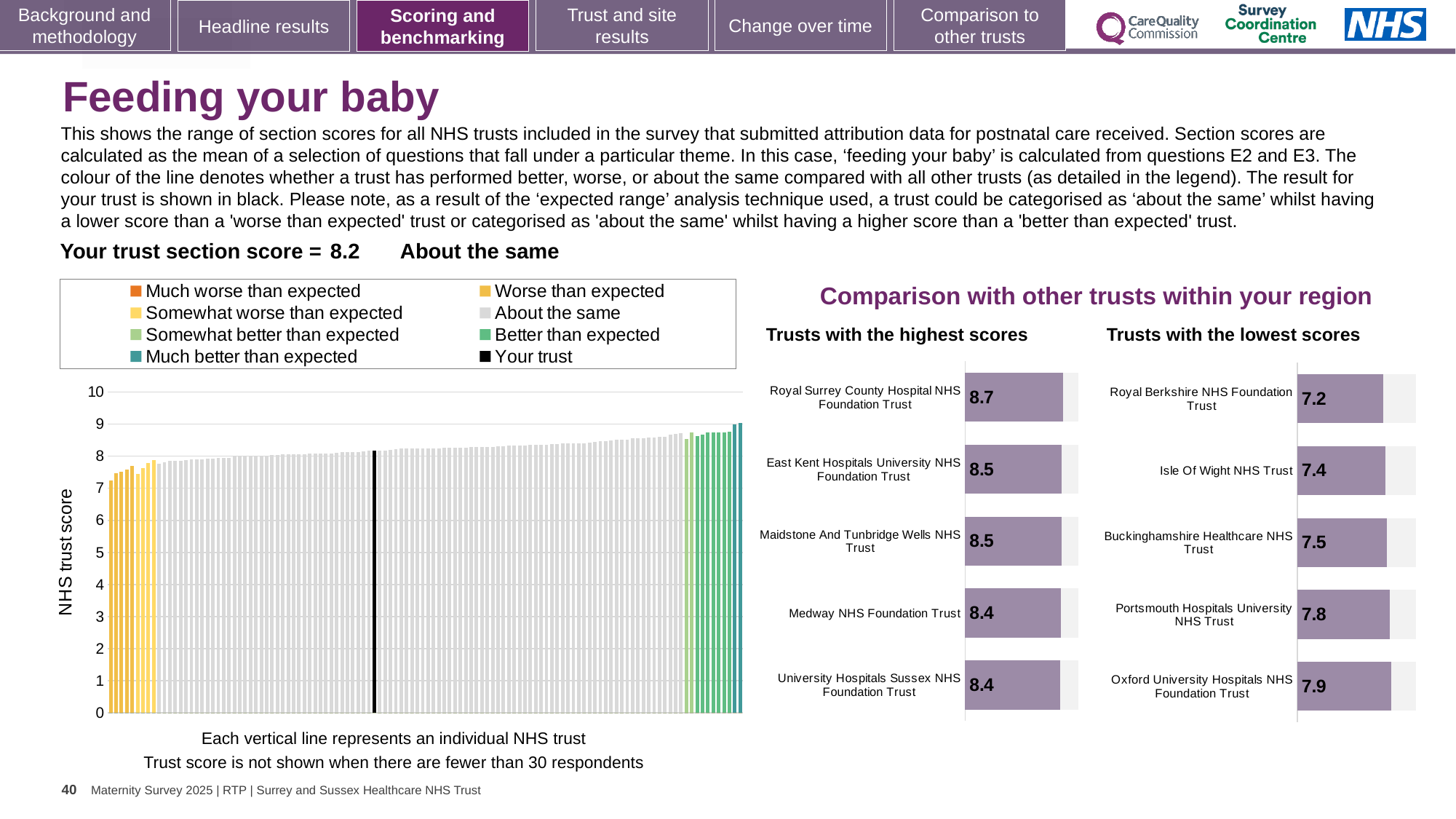
In the 'Trusts with the lowest scores' chart, what is the score for Isle Of Wight NHS Trust? 7.4 How many trusts are listed in the 'Trusts with the highest scores' chart? 5 In the 'Trusts with the highest scores' chart, what is the difference between the scores of Royal Surrey County Hospital NHS Foundation Trust and Medway NHS Foundation Trust? 0.3 In the 'Trusts with the highest scores' chart, which trust has the highest score? Royal Surrey County Hospital NHS Foundation Trust In the NHS trust score chart on the left, what colour represents 'Your trust' in the legend? Black In the 'Trusts with the lowest scores' chart, which has the larger score: Buckinghamshire Healthcare NHS Trust or Portsmouth Hospitals University NHS Trust? Portsmouth Hospitals University NHS Trust What kind of chart is the NHS trust score chart on the left of the slide? Bar chart In the NHS trust score chart on the left, do the bar values rise or fall from left to right? Rise In the 'Trusts with the lowest scores' chart, what is the difference between the scores of Oxford University Hospitals NHS Foundation Trust and Royal Berkshire NHS Foundation Trust? 0.7 In the 'Trusts with the highest scores' chart, what is the score for Royal Surrey County Hospital NHS Foundation Trust? 8.7 In the 'Trusts with the lowest scores' chart, which trust has the lowest score? Royal Berkshire NHS Foundation Trust How many entries does the legend of the NHS trust score chart list? 8